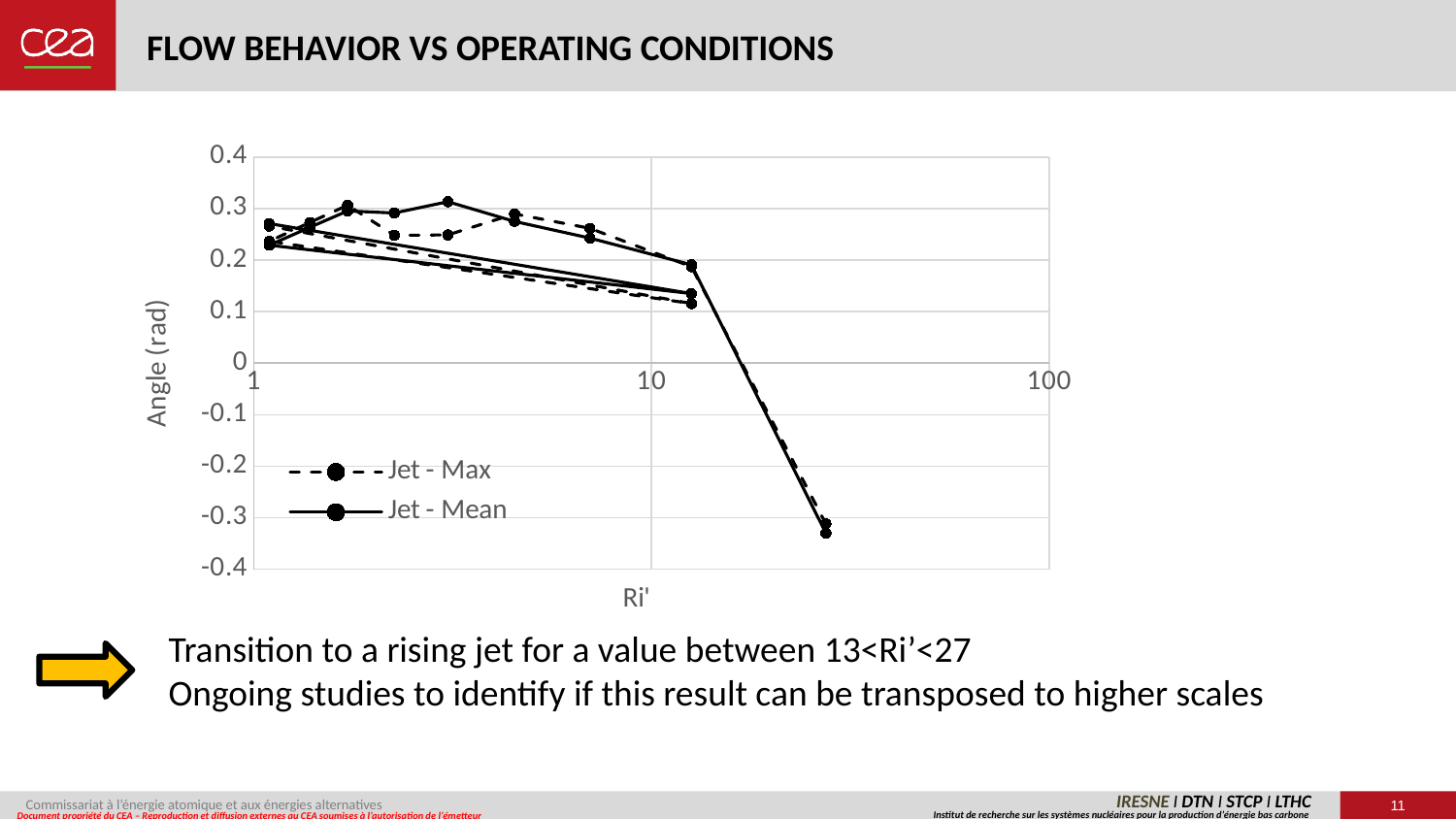
Is the angle value at Ri' around 27 larger or smaller than the angle value at Ri' = 1? smaller Is the Jet - Mean value at Ri' = 1 greater or less than 0.2? greater What are the two series named in the legend? Jet - Max and Jet - Mean Is the angle value at the rightmost data point (Ri' around 27) greater or less than -0.2? less Do the angle values rise or fall between Ri' around 13 and Ri' around 27? fall What is the title of the x axis? Ri' How many series does the legend list? 2 What kind of chart is shown on the slide? Line chart Is the angle value at the rightmost data point (Ri' around 27) greater or less than 0? less